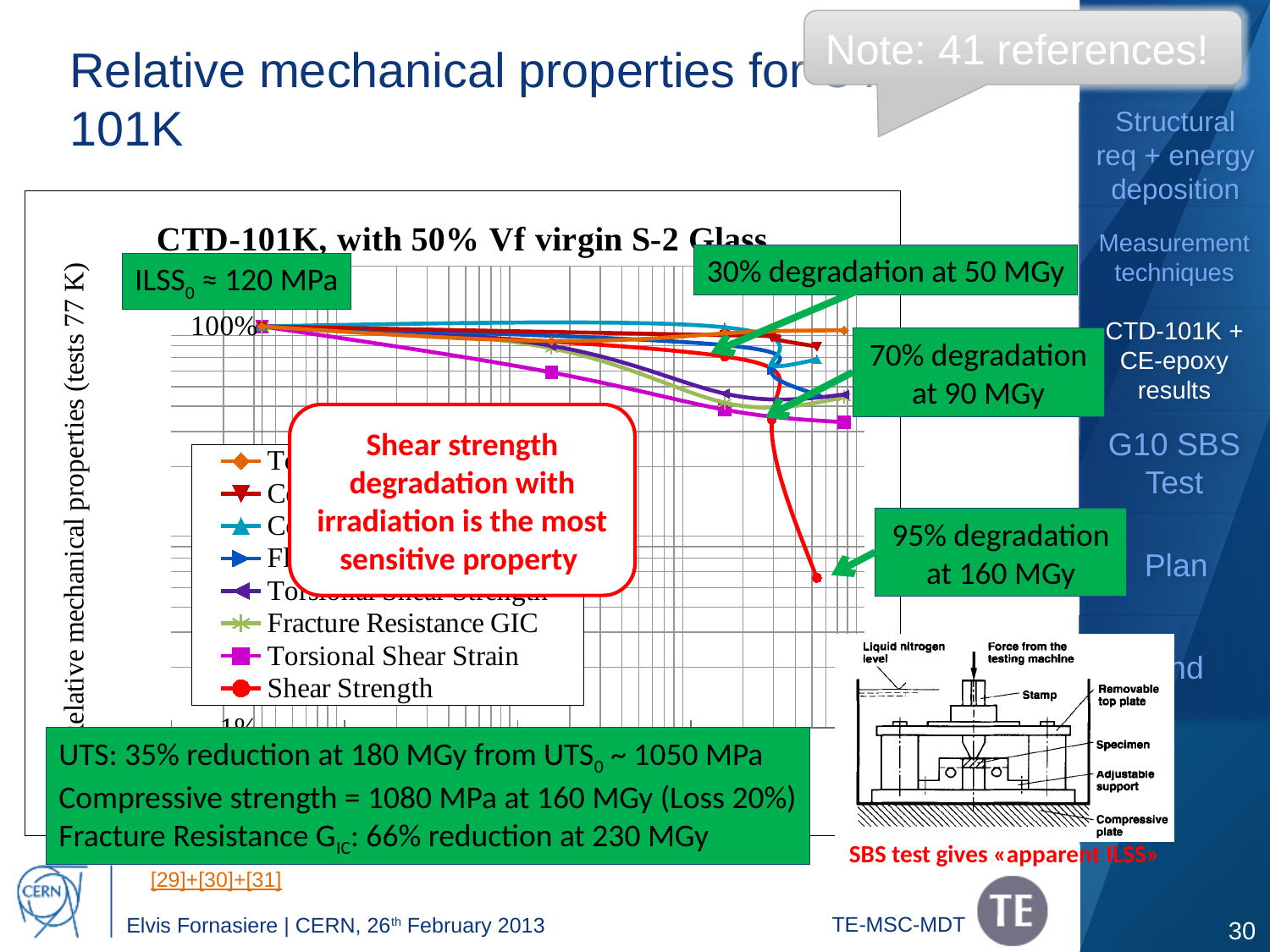
Which series in the chart falls to the lowest relative value at the right-hand end of the plotted data? Shear Strength According to the annotation on the chart, what degradation does shear strength show at 90 MGy? 70% Which series is plotted with a magenta square marker? Torsional Shear Strain What kind of chart is shown on the slide? line chart What is the title of the chart? CTD-101K, with 50% Vf virgin S-2 Glass Is the relative value of the Shear Strength series at its last plotted point greater or less than 100%? less According to the annotation on the chart, what degradation does shear strength show at 160 MGy? 95% How many series does the chart legend list? 8 According to the annotation on the chart, what degradation does shear strength show at 50 MGy? 30% Do the plotted relative mechanical properties generally rise or fall along the x axis? fall What is the label of the chart's vertical axis? Relative mechanical properties (tests 77 K)